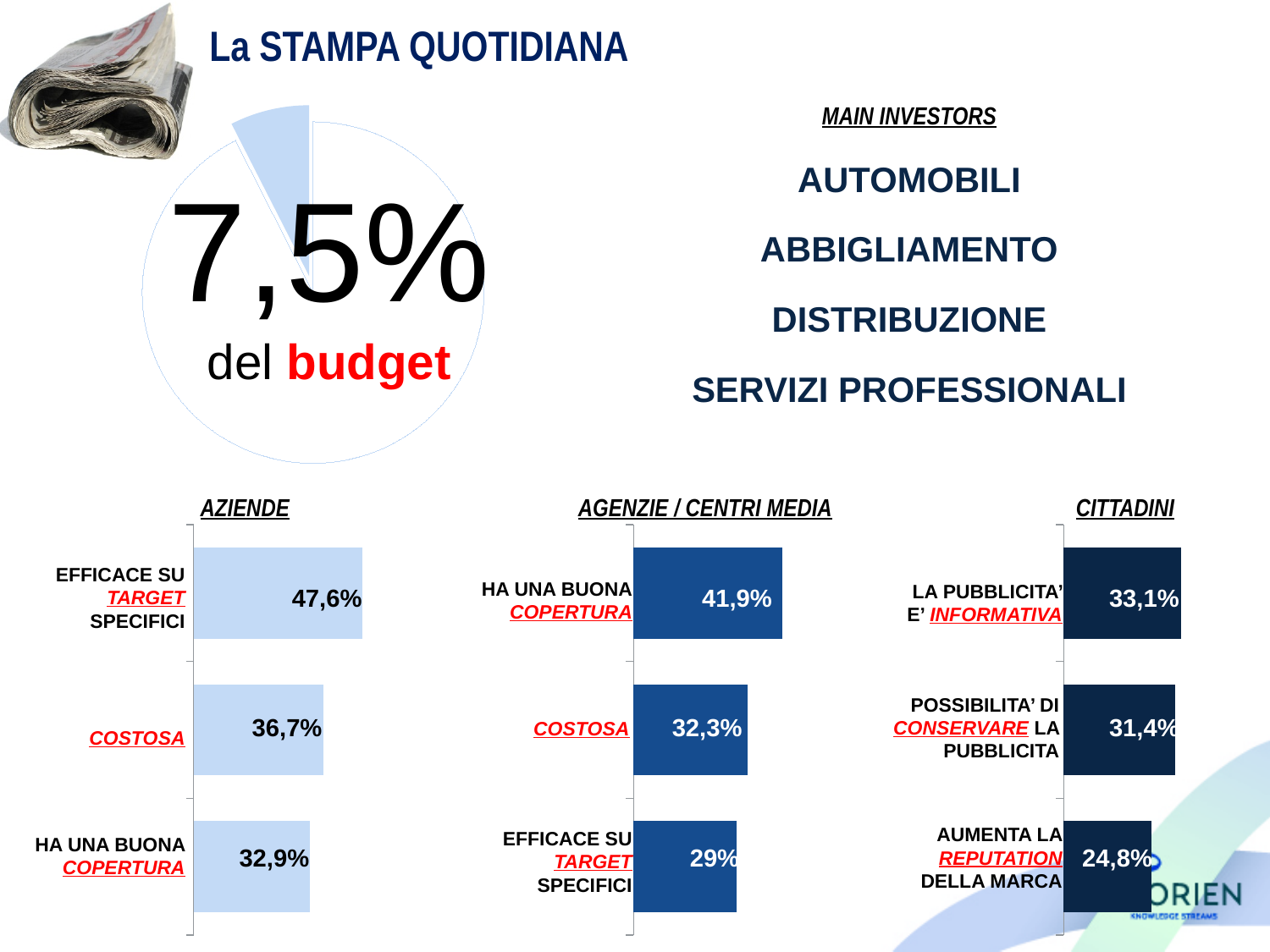
How many categories does the CITTADINI chart show? 3 In the CITTADINI chart, which category has the highest value? LA PUBBLICITA' E' INFORMATIVA In the CITTADINI chart, what is the value for AUMENTA LA REPUTATION DELLA MARCA? 24,8% What share of the budget does the pie chart at the top left show for daily press? 7,5% In the AZIENDE chart, what is the value for COSTOSA? 36,7% In the AZIENDE chart, which category has the lowest value? HA UNA BUONA COPERTURA In the AGENZIE / CENTRI MEDIA chart, what is the value for EFFICACE SU TARGET SPECIFICI? 29% In the AGENZIE / CENTRI MEDIA chart, what is the difference between HA UNA BUONA COPERTURA and COSTOSA? 9,6% Which is larger: COSTOSA in the AZIENDE chart or COSTOSA in the AGENZIE / CENTRI MEDIA chart? COSTOSA in the AZIENDE chart In the AZIENDE chart, what is the value for EFFICACE SU TARGET SPECIFICI? 47,6% In the AGENZIE / CENTRI MEDIA chart, what is the value for HA UNA BUONA COPERTURA? 41,9% What kind of chart is the AZIENDE chart? bar chart